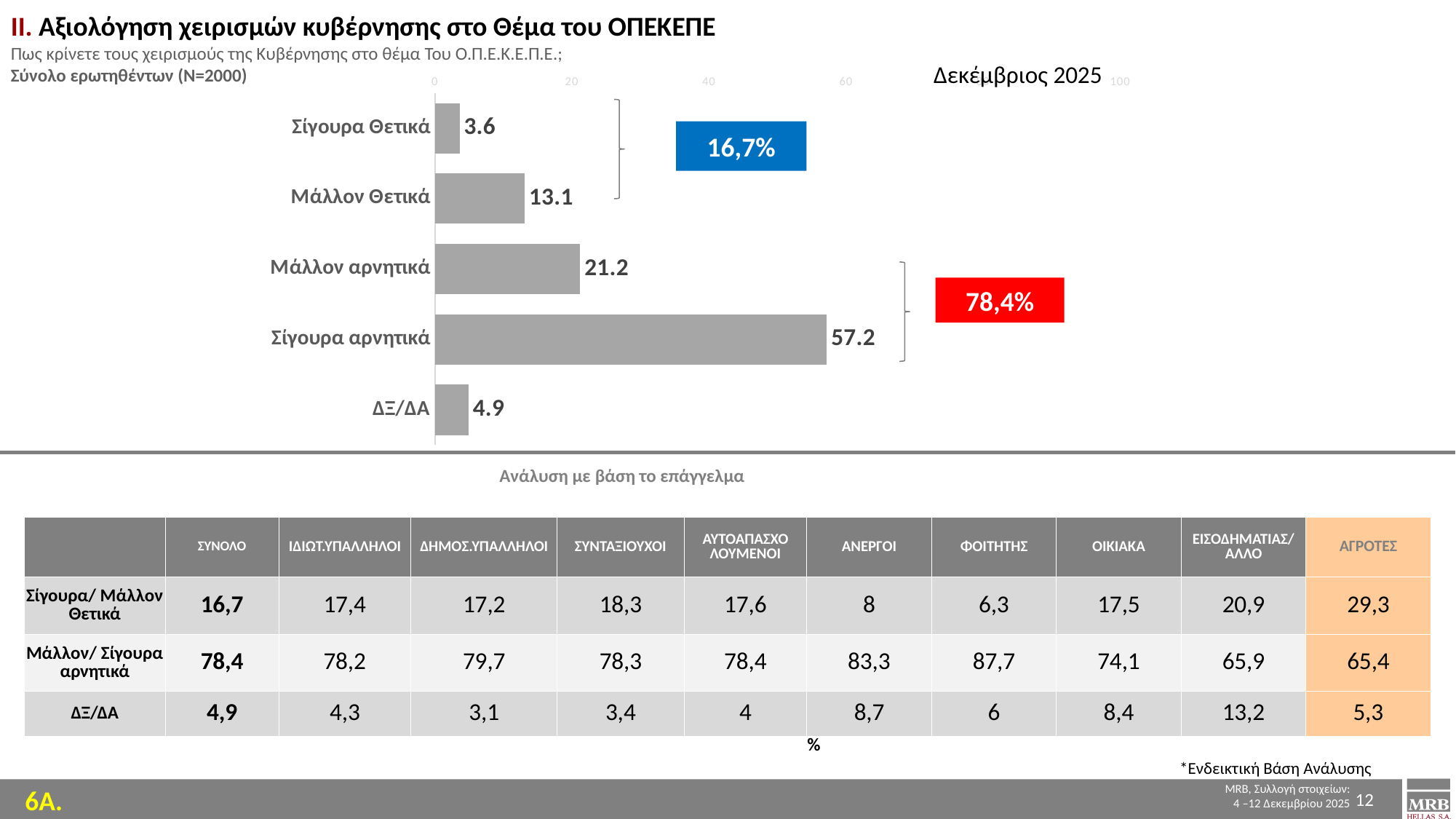
What is the value for Μάλλον Θετικά? 13.1 What kind of chart is shown on the slide? bar chart What percentage is shown in the blue callout box next to the positive categories? 16,7% How many categories are shown in the bar chart? 5 What is the value for ΔΞ/ΔΑ in the bar chart? 4.9 What percentage is shown in the red callout box next to the negative categories? 78,4% What is the value for Σίγουρα αρνητικά? 57.2 Is the value for Μάλλον αρνητικά greater or less than 20? greater Which is larger, Μάλλον Θετικά or ΔΞ/ΔΑ? Μάλλον Θετικά Which category has the highest value? Σίγουρα αρνητικά What is the difference between Σίγουρα αρνητικά and Μάλλον αρνητικά? 36.0 Which category has the lowest value? Σίγουρα Θετικά